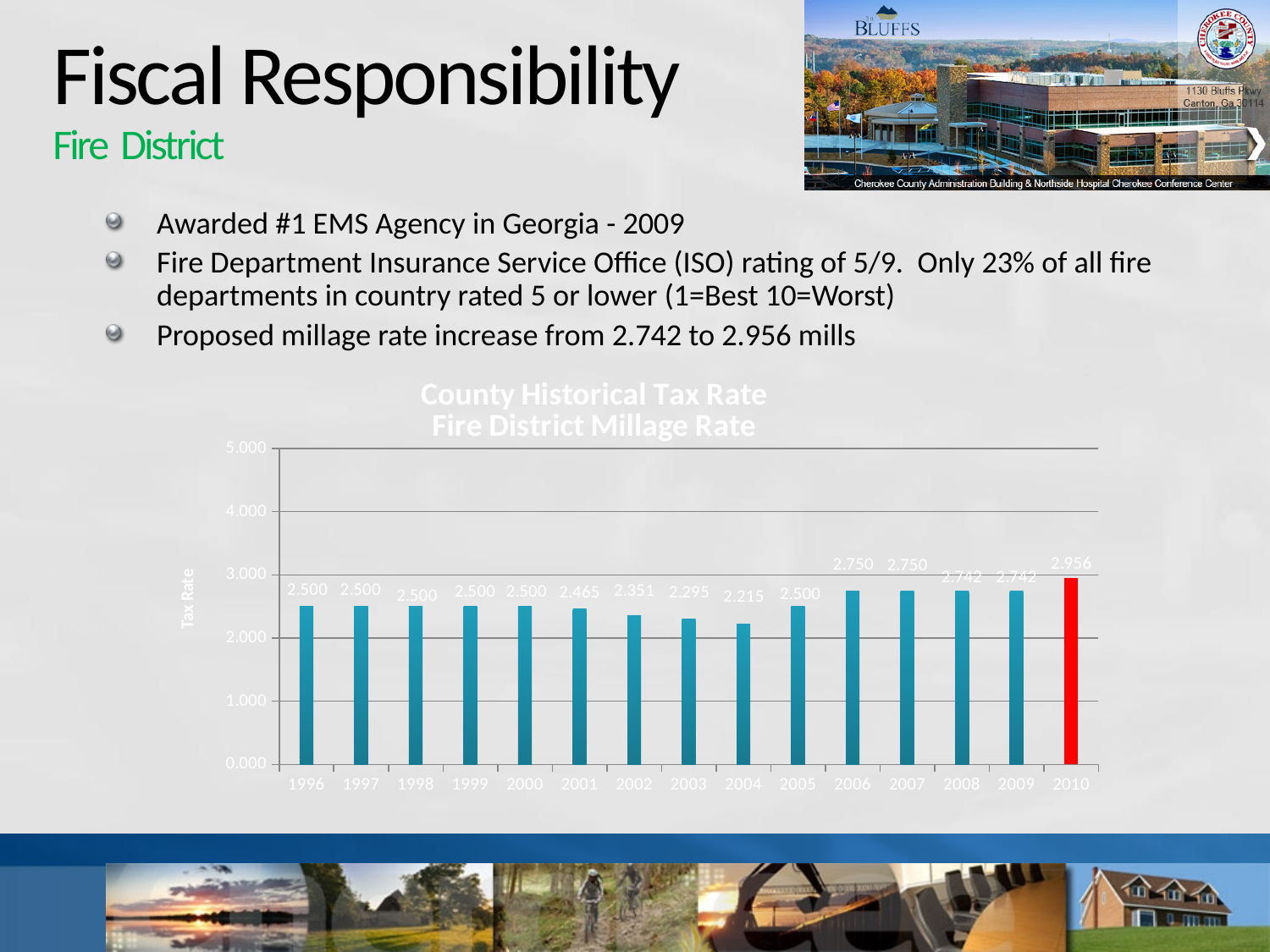
Which year has the lowest millage rate? 2004 What is the Fire District millage rate for 2004? 2.215 What is the difference between the millage rate in 2006 and in 2004? 0.535 Which is larger, the millage rate in 2003 or in 2005? 2005 Is the millage rate for 2007 greater or less than 2.000? greater How many years are shown on the x axis of the chart? 15 Which year has the highest millage rate? 2010 What is the title of the chart? County Historical Tax Rate Fire District Millage Rate What is the Fire District millage rate for 2002? 2.351 What type of chart is shown on the slide? bar chart What is the Fire District millage rate for 2010? 2.956 What is the difference between the millage rate in 2010 and in 2009? 0.214